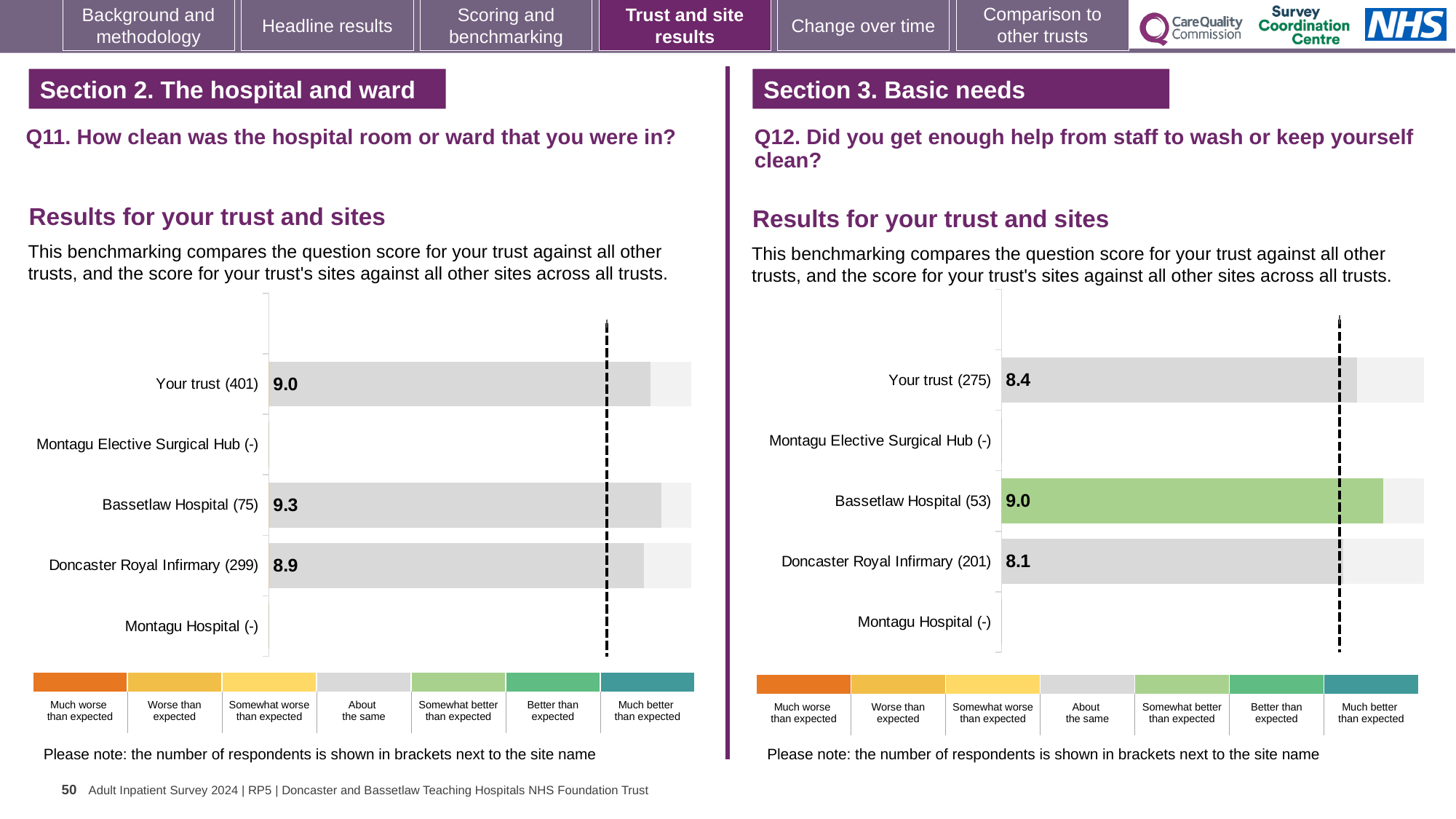
In the Q12 chart (right), what is the score for Doncaster Royal Infirmary? 8.1 In the Q11 chart (left), what is the score for Your trust? 9.0 In the Q12 chart (right), what is the score for Bassetlaw Hospital? 9.0 In the Q11 chart (left), what is the score for Bassetlaw Hospital? 9.3 In the Q12 chart (right), is the score for Your trust larger or smaller than the score for Bassetlaw Hospital? smaller In the Q11 chart (left), what is the difference between the scores for Bassetlaw Hospital and Doncaster Royal Infirmary? 0.4 In the Q12 chart (right), which site's bar is coloured green, indicating 'Somewhat better than expected'? Bassetlaw Hospital In the Q12 chart (right), which site has the lowest score among those with a value shown? Doncaster Royal Infirmary In the Q12 chart (right), what is the difference between the scores for Bassetlaw Hospital and Your trust? 0.6 In the Q11 chart (left), which site has the highest score? Bassetlaw Hospital What kind of chart is used in the Q11 chart (left)? bar chart In the Q11 chart (left), how many respondents are shown for Doncaster Royal Infirmary? 299